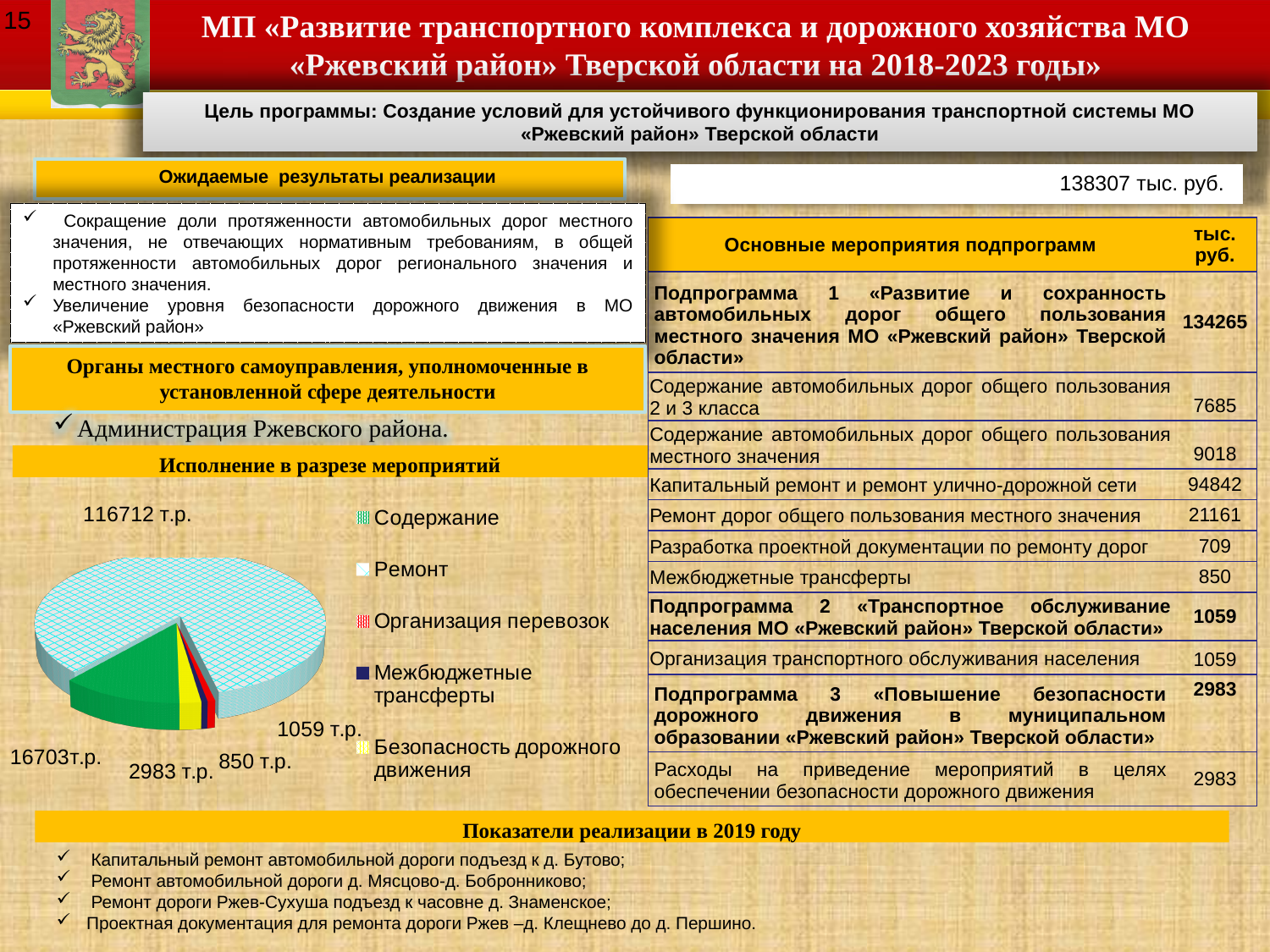
What kind of chart is shown under the heading «Исполнение в разрезе мероприятий»? pie chart What is the difference between the labelled values 2983 т.р. and 850 т.р. on the pie chart? 2133 т.р. How many data labels are printed on the pie chart? 5 What is the difference between the two largest labelled values on the pie chart, 116712 т.р. and 16703 т.р.? 100009 т.р. What is the total of all five values labelled on the pie chart? 138307 т.р. What is the last entry in the pie chart's legend? Безопасность дорожного движения What is the smallest value labelled on the pie chart? 850 т.р. What is the largest value labelled on the pie chart? 116712 т.р. Which labelled value on the pie chart is larger: 2983 т.р. or 1059 т.р.? 2983 т.р. What is the first entry in the pie chart's legend? Содержание How many entries does the legend of the pie chart list? 5